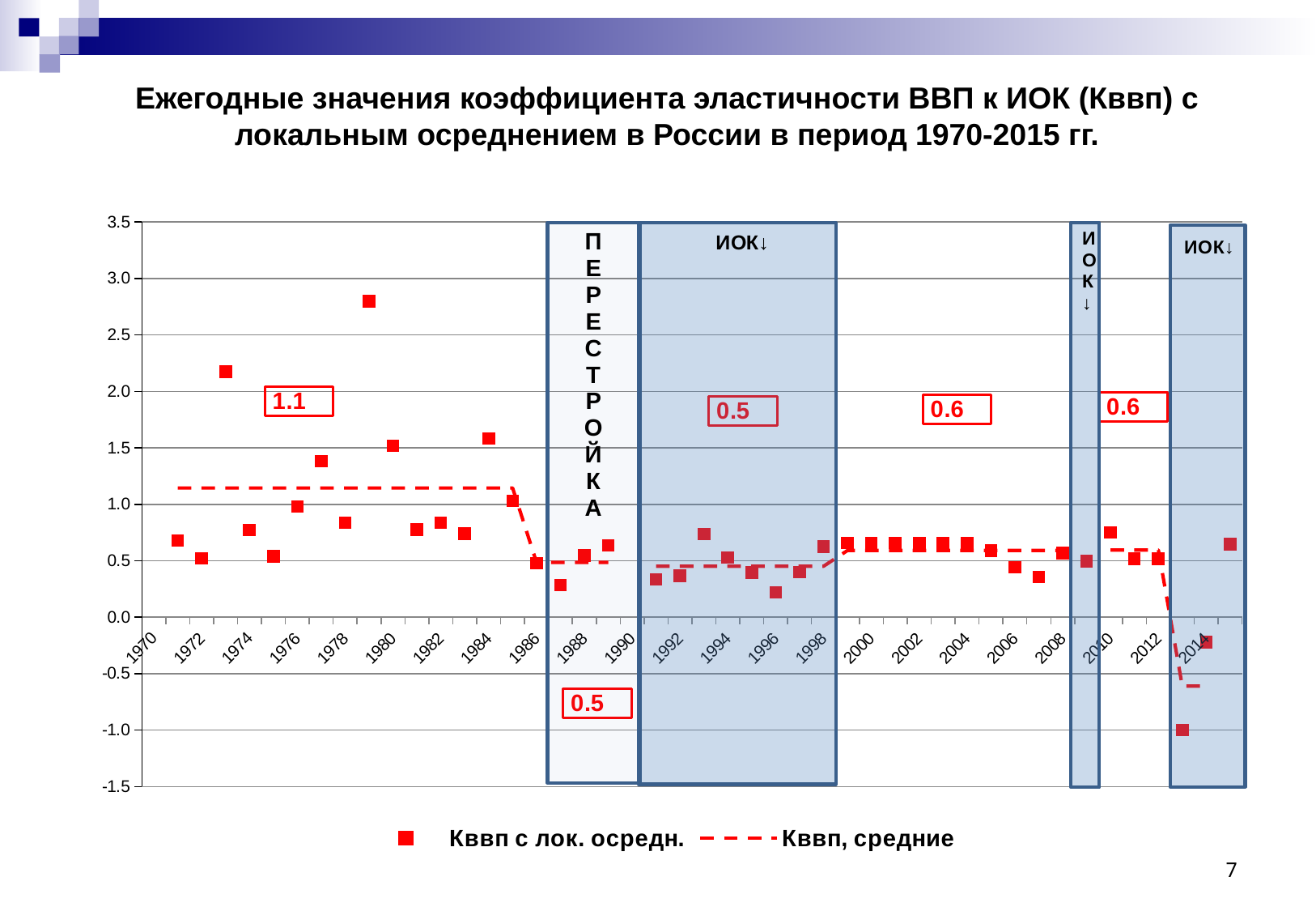
Which year has the lowest value of Кввп с лок. осредн.? 2013 Which year has the highest value of Кввп с лок. осредн.? 1979 What average value (Кввп, средние) is printed in the box for the period before Перестройка (1970s–early 1980s)? 1.1 Is the value for 2015 greater or less than 0.0? greater What kind of chart is shown on the slide? line chart What are the two series named in the legend? Кввп с лок. осредн. and Кввп, средние Is the value for 1973 greater or less than 2.0? greater Is the value for 1996 greater or less than 0.5? less What average value is printed in the box for the Перестройка period? 0.5 What average value is printed in the box for the 1999–2008 period? 0.6 How many series does the legend list? 2